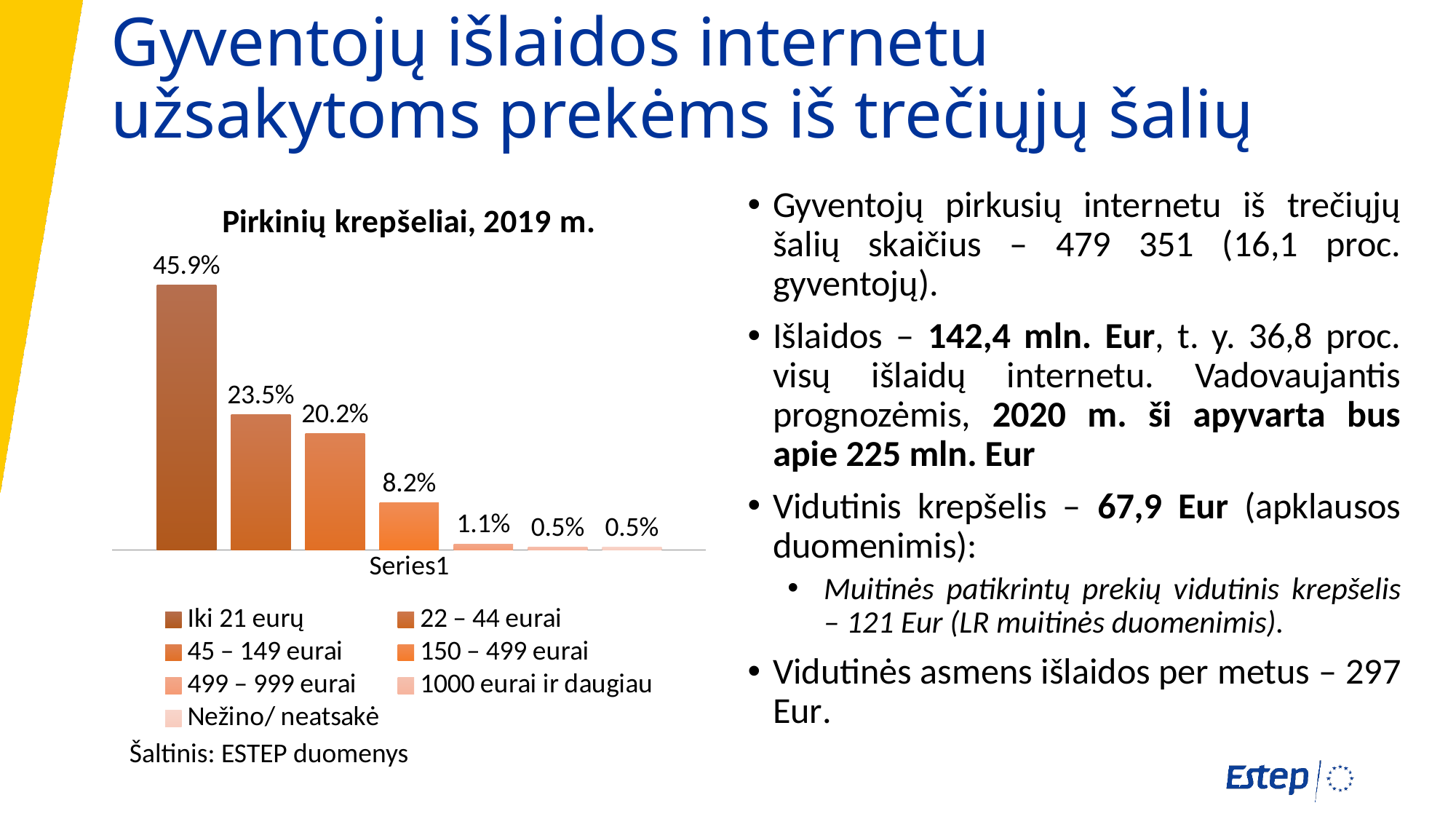
Which series has the highest value in the chart? Iki 21 eurų What is the difference between the values for 'Iki 21 eurų' and '22 – 44 eurai'? 22.4% What is the difference between the values for '45 – 149 eurai' and '150 – 499 eurai'? 12.0% How many bars are plotted in the chart? 7 What is the value for '499 – 999 eurai' in the chart? 1.1% What is the value for 'Iki 21 eurų' in the chart? 45.9% What is the value for '22 – 44 eurai' in the chart? 23.5% What is the title of the chart? Pirkinių krepšeliai, 2019 m. What kind of chart is shown on the slide? Bar chart What is the value for '150 – 499 eurai' in the chart? 8.2% How many series does the legend list? 7 Which is larger, the value for '22 – 44 eurai' or the value for '45 – 149 eurai'? 22 – 44 eurai